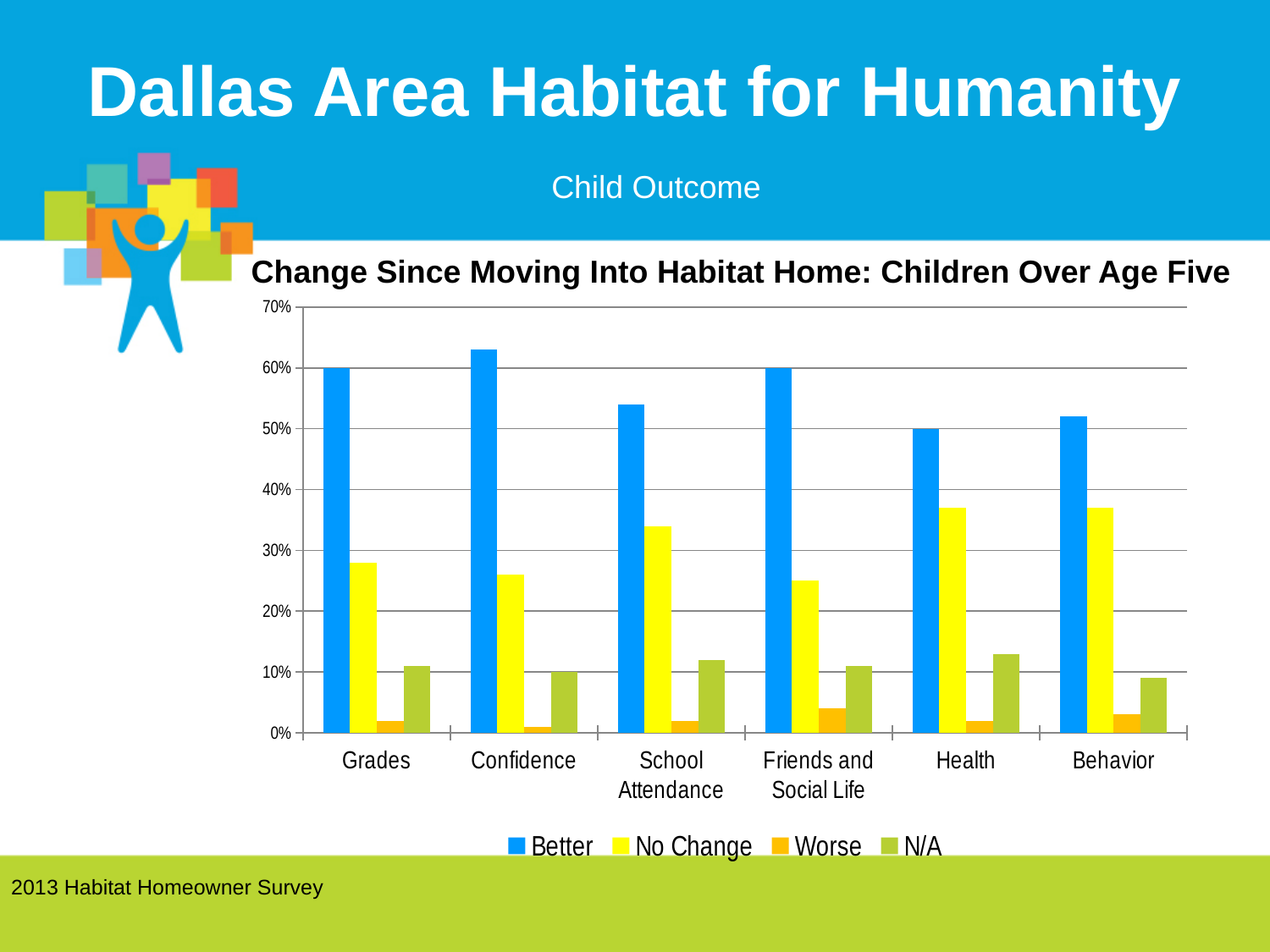
What colour represents the Better series in the legend? blue How many categories are shown on the x axis? 6 What kind of chart is shown on the slide? bar chart Which category has the highest value for the Better series? Confidence Is the Worse value for Friends and Social Life greater or less than 10%? less Which is larger: the Better value for Grades or for Behavior? Grades Which category has the lowest value for the Better series? Health Is the Better value for School Attendance greater or less than 50%? greater Which is larger: the No Change value for School Attendance or for Confidence? School Attendance How many series does the legend list? 4 Is the N/A value for Health greater or less than 10%? greater